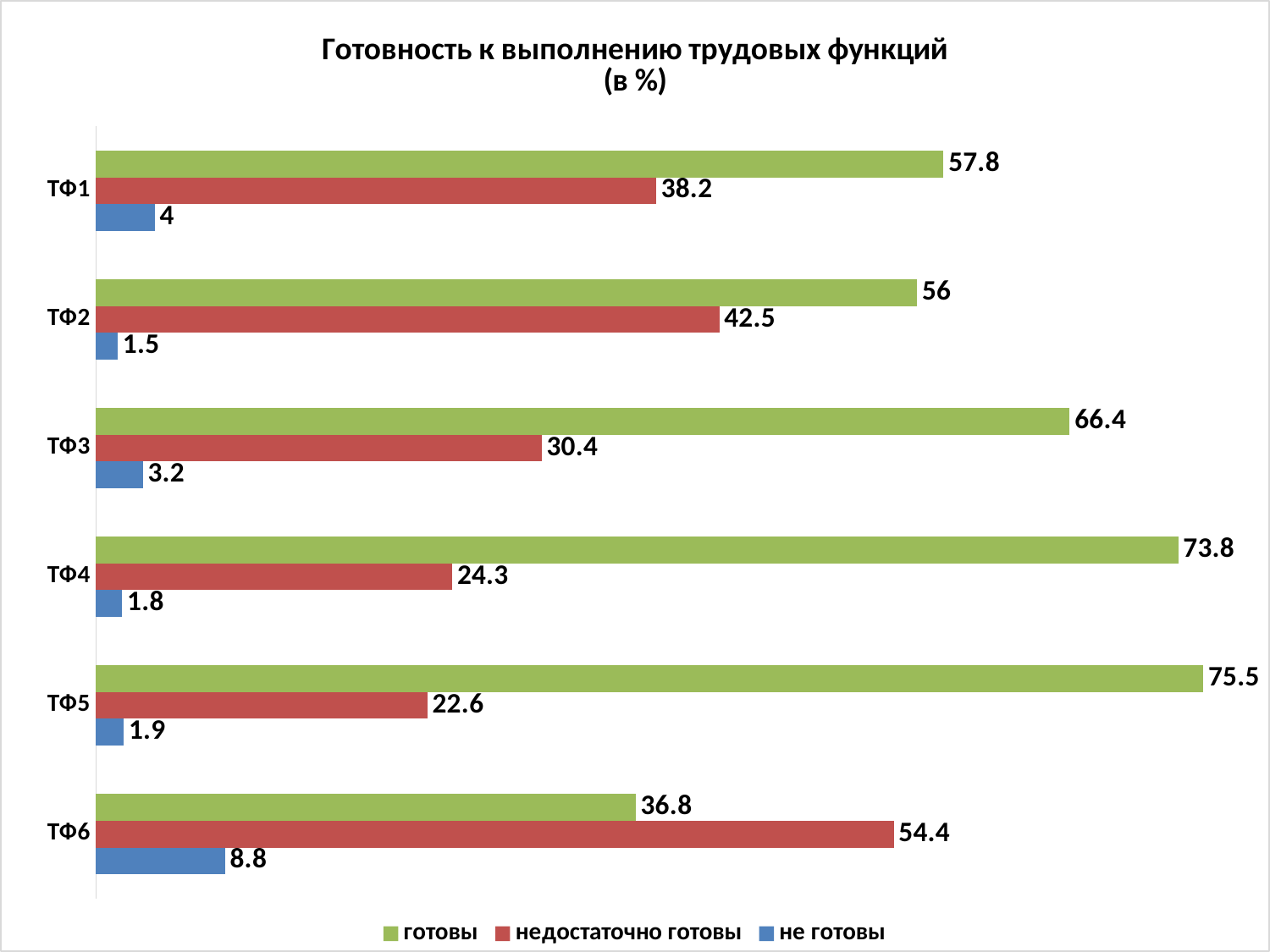
Which colour represents the "не готовы" series? blue What is the value for "готовы" for ТФ3? 66.4 Which category has the highest value for "готовы"? ТФ5 What kind of chart is shown on the slide? bar chart Which category has the lowest value for "не готовы"? ТФ2 How many series does the legend list? 3 What is the value for "недостаточно готовы" for ТФ6? 54.4 What is the difference between the "готовы" and "недостаточно готовы" values for ТФ4? 49.5 What is the value for "не готовы" for ТФ1? 4 Which is larger for ТФ6: "готовы" or "недостаточно готовы"? недостаточно готовы What is the title of the chart? Готовность к выполнению трудовых функций (в %) How many categories are shown on the chart? 6